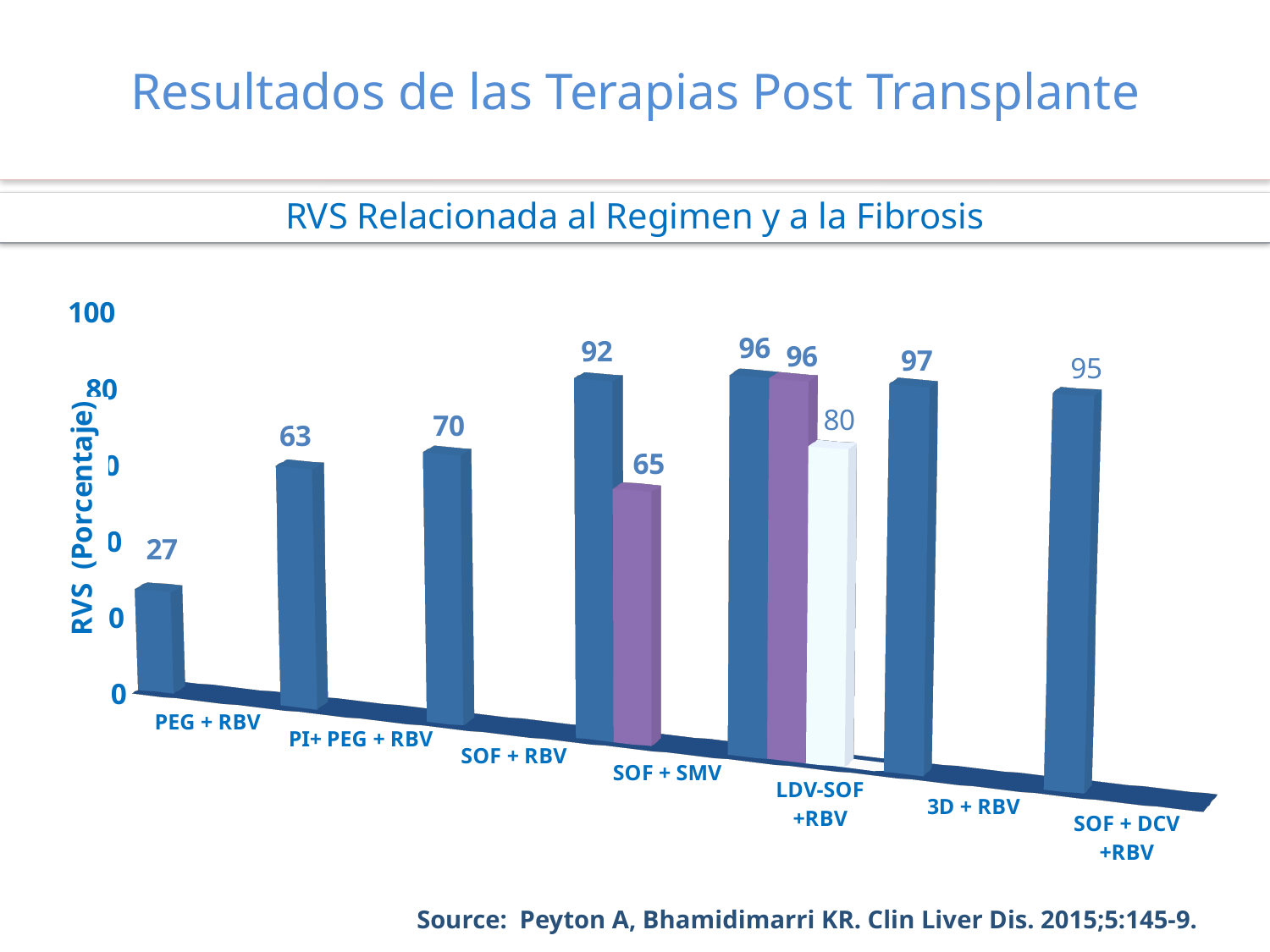
What is the value of the blue bar for PEG + RBV? 27 What kind of chart is shown on the slide? Bar chart What is the value of the blue bar for SOF + DCV +RBV? 95 What is the label of the vertical axis? RVS (Porcentaje) What is the value of the light-coloured bar for LDV-SOF +RBV? 80 What is the difference between the blue bar values for 3D + RBV and PEG + RBV? 70 What is the value of the blue bar for 3D + RBV? 97 Which has a larger blue bar value, SOF + RBV or PI+ PEG + RBV? SOF + RBV Which regimen has the highest blue bar value? 3D + RBV How many regimens are shown on the x axis? 7 Which regimen has the lowest blue bar value? PEG + RBV What is the value of the purple bar for SOF + SMV? 65